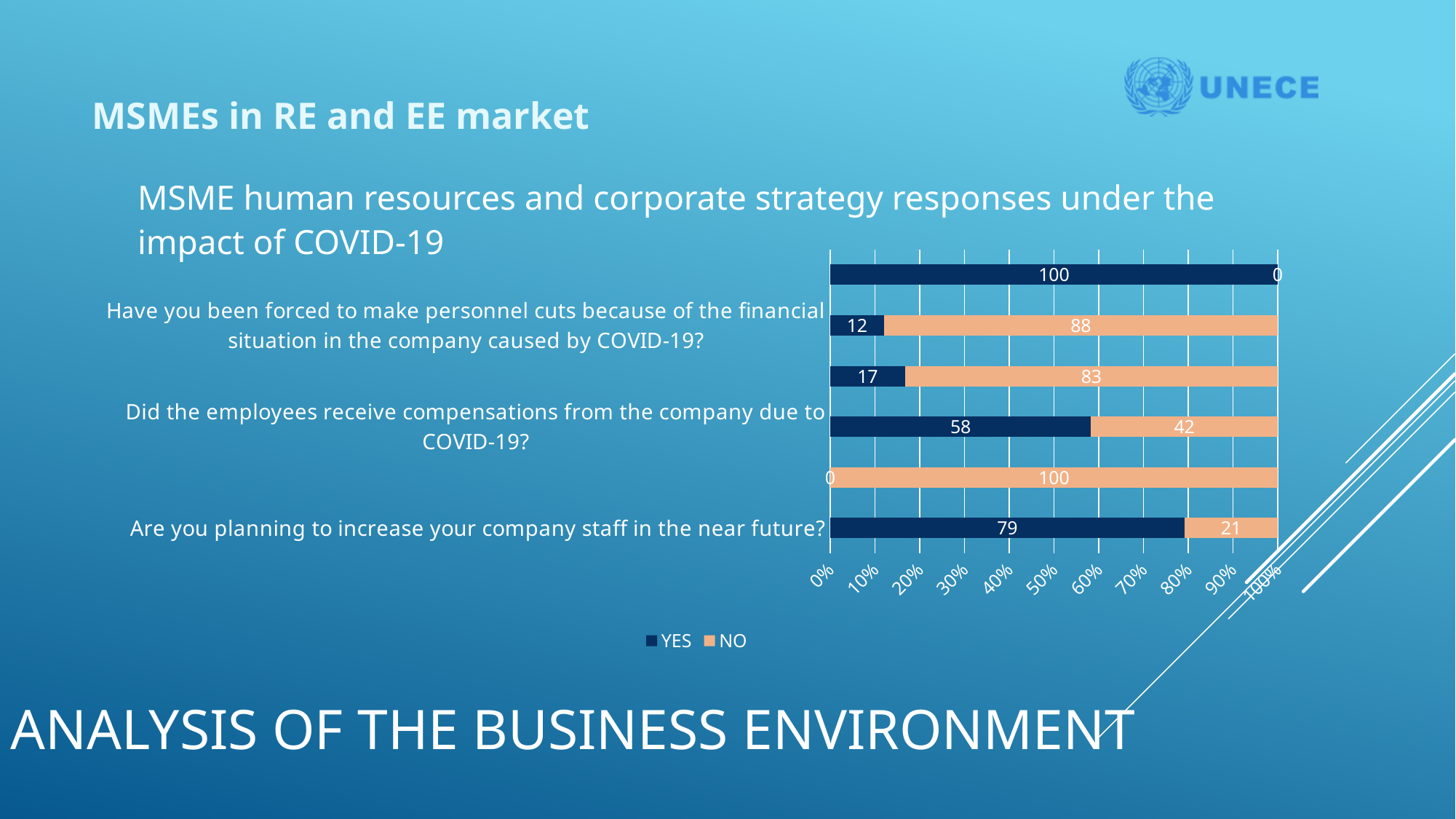
What is the difference between the YES and NO values for "Are you planning to increase your company staff in the near future?" 58 For "Did the employees receive compensations from the company due to COVID-19?", which is larger, YES or NO? YES What kind of chart is shown on the slide? bar chart What is the YES value for "Have you been forced to make personnel cuts because of the financial situation in the company caused by COVID-19?" 12 How many bars are plotted in the chart? 6 What is the NO value for "Are you planning to increase your company staff in the near future?" 21 What is the total of the YES and NO values for "Have you been forced to make personnel cuts because of the financial situation in the company caused by COVID-19?" 100 What is the NO value for "Have you been forced to make personnel cuts because of the financial situation in the company caused by COVID-19?" 88 What are the two series named in the chart legend? YES and NO What is the YES value for "Did the employees receive compensations from the company due to COVID-19?" 58 What is the YES value shown on the topmost bar of the chart? 100 How many series does the chart legend list? 2